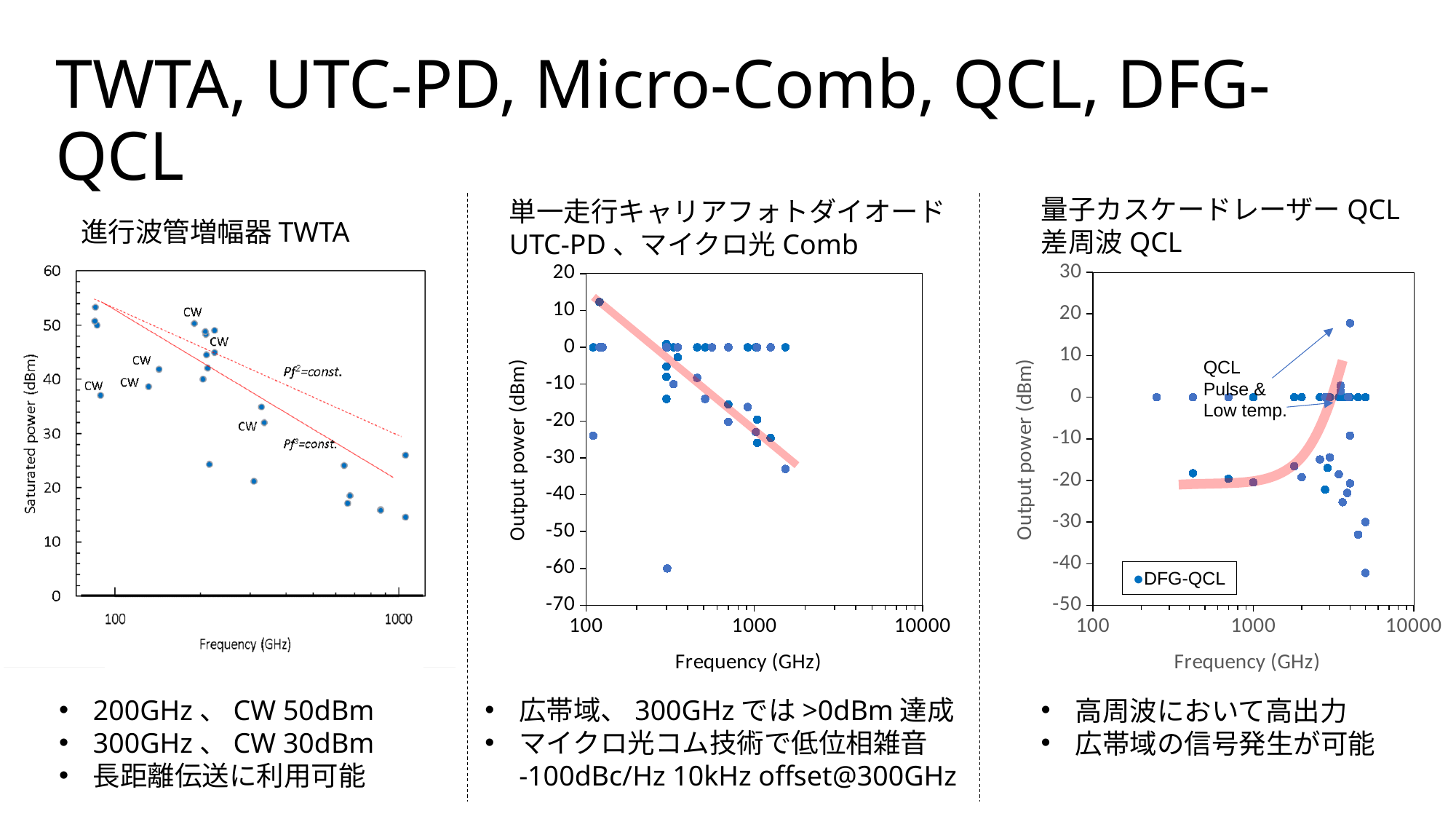
In the right DFG-QCL chart, is the lowest plotted output power value greater or less than -30 dBm? less In the middle UTC-PD chart, is the lowest plotted output power value greater or less than -50 dBm? less In the left TWTA chart, is the highest plotted saturated power value greater or less than 50 dBm? greater In the right DFG-QCL chart, does the highlighted trend of output power rise or fall as frequency increases? rise What kind of chart is the left chart titled 進行波管増幅器 TWTA? scatter chart In the middle UTC-PD chart, does the highlighted trend of output power rise or fall as frequency increases? fall What kind of chart is the right chart under 量子カスケードレーザー QCL 差周波 QCL? scatter chart How many series does the legend of the right DFG-QCL chart list? 1 In the left TWTA chart, what is the label of the y axis? Saturated power (dBm) In the middle UTC-PD chart, what is the label of the x axis? Frequency (GHz) In the left TWTA chart, does the saturated power generally rise or fall as frequency increases? fall